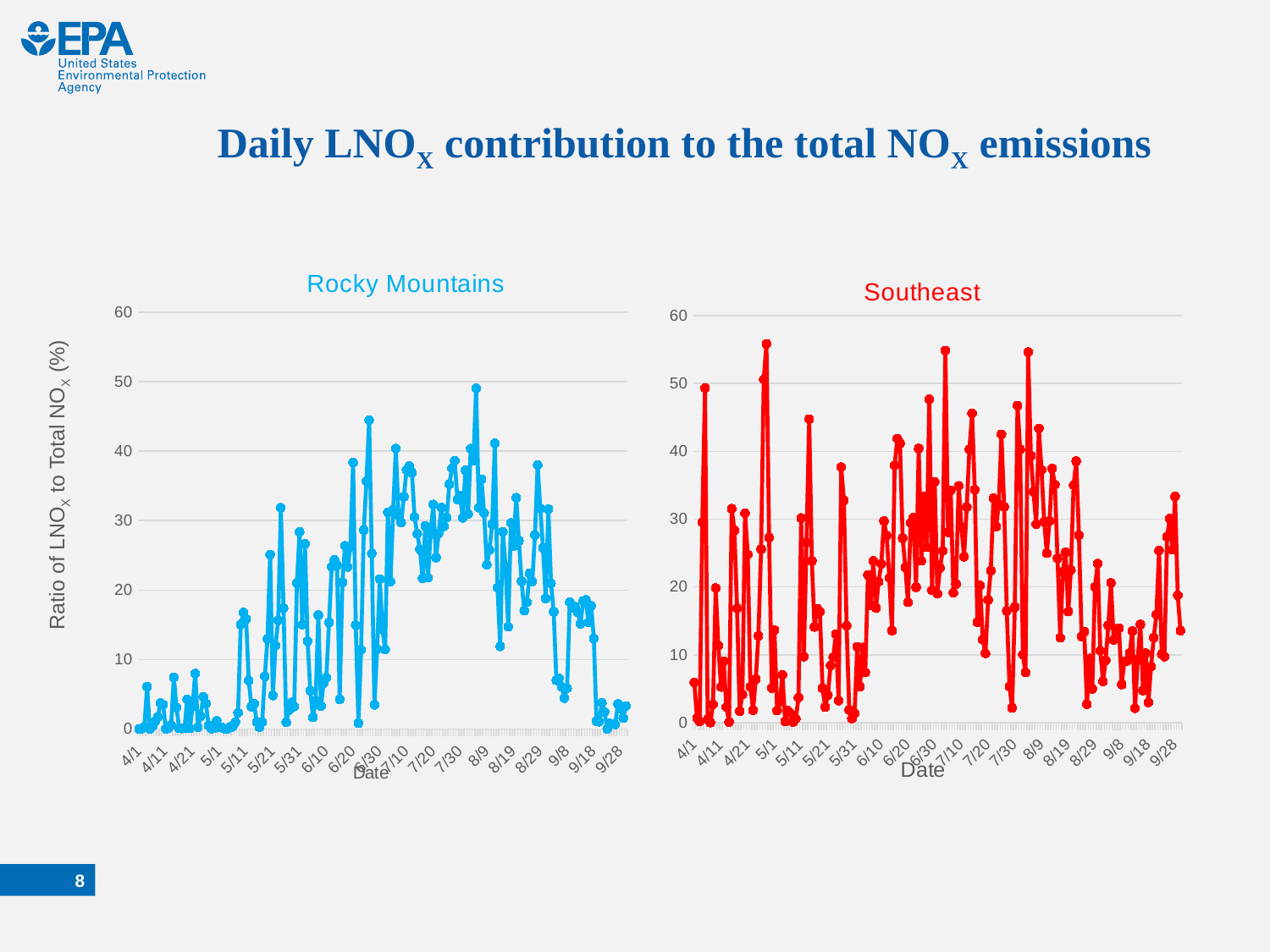
What colour is the line in the Southeast chart? red What kind of chart is the Rocky Mountains chart? line chart What is the title of the chart on the right side of the slide? Southeast What is the highest value shown on the y axis of the Rocky Mountains chart? 60 In the Rocky Mountains chart, do the values generally rise or fall from 4/1 to 7/30? rise In the Rocky Mountains chart, is the peak near 6/30 greater or less than 40? greater Which chart reaches a higher maximum value, Rocky Mountains or Southeast? Southeast In the Southeast chart, is the value for 4/1 greater or less than 40? less How many data series are plotted in the Southeast chart? 1 In the Rocky Mountains chart, is the value for 4/1 greater or less than 10? less In the Rocky Mountains chart, do the values generally rise or fall from 8/9 to 9/28? fall